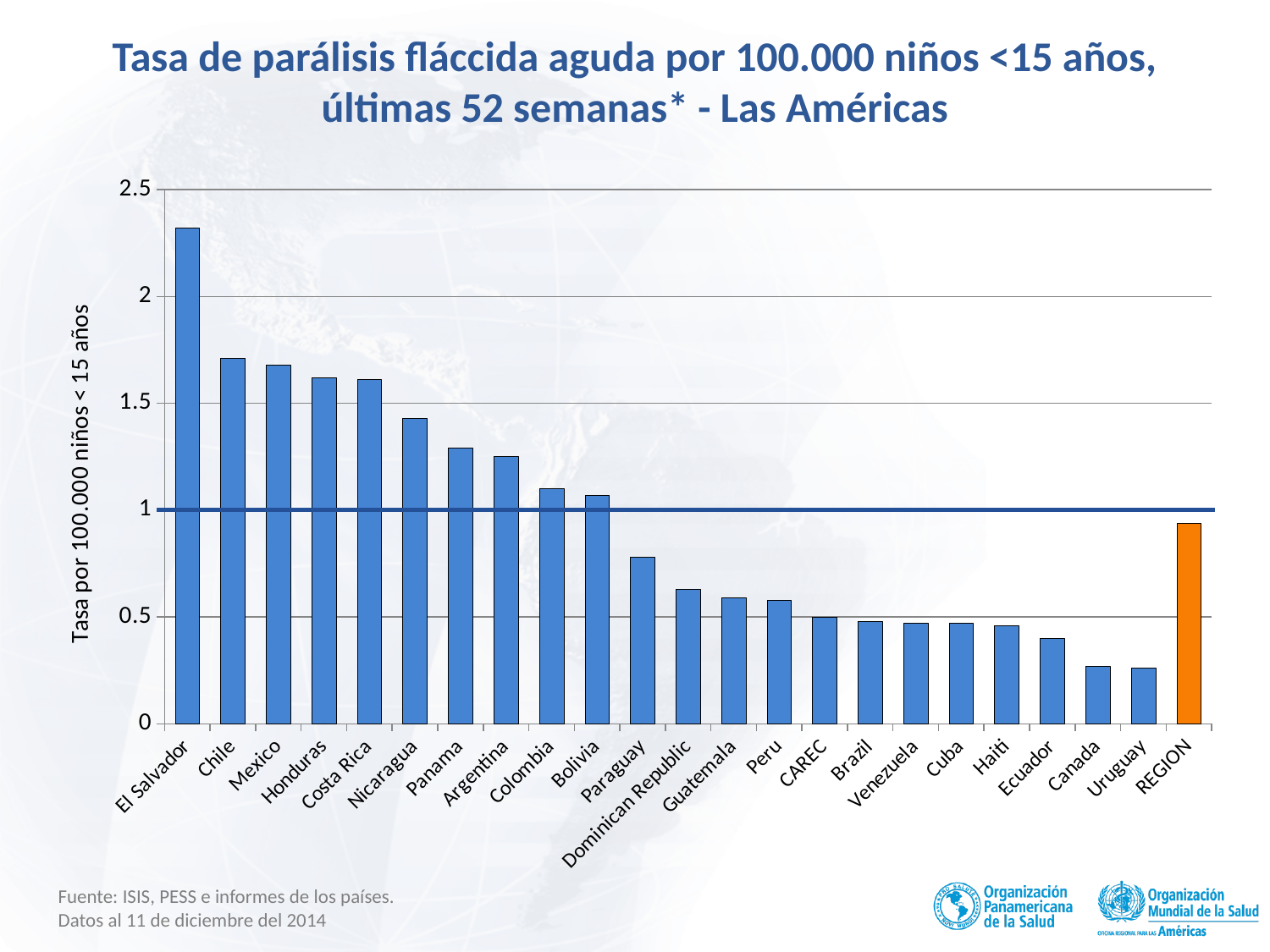
Is the value for Chile greater or less than 1.5? greater Is the value for Paraguay greater or less than 1? less What kind of chart is shown on the slide? bar chart How many bars are plotted in the chart, including REGION? 23 Which bar in the chart is coloured orange instead of blue? REGION Do the country values rise or fall from left to right across the x axis (excluding the REGION bar)? fall Which has a higher value, Nicaragua or Panama? Nicaragua Is the value for Canada greater or less than 0.5? less Which country has the highest rate of acute flaccid paralysis in the chart? El Salvador